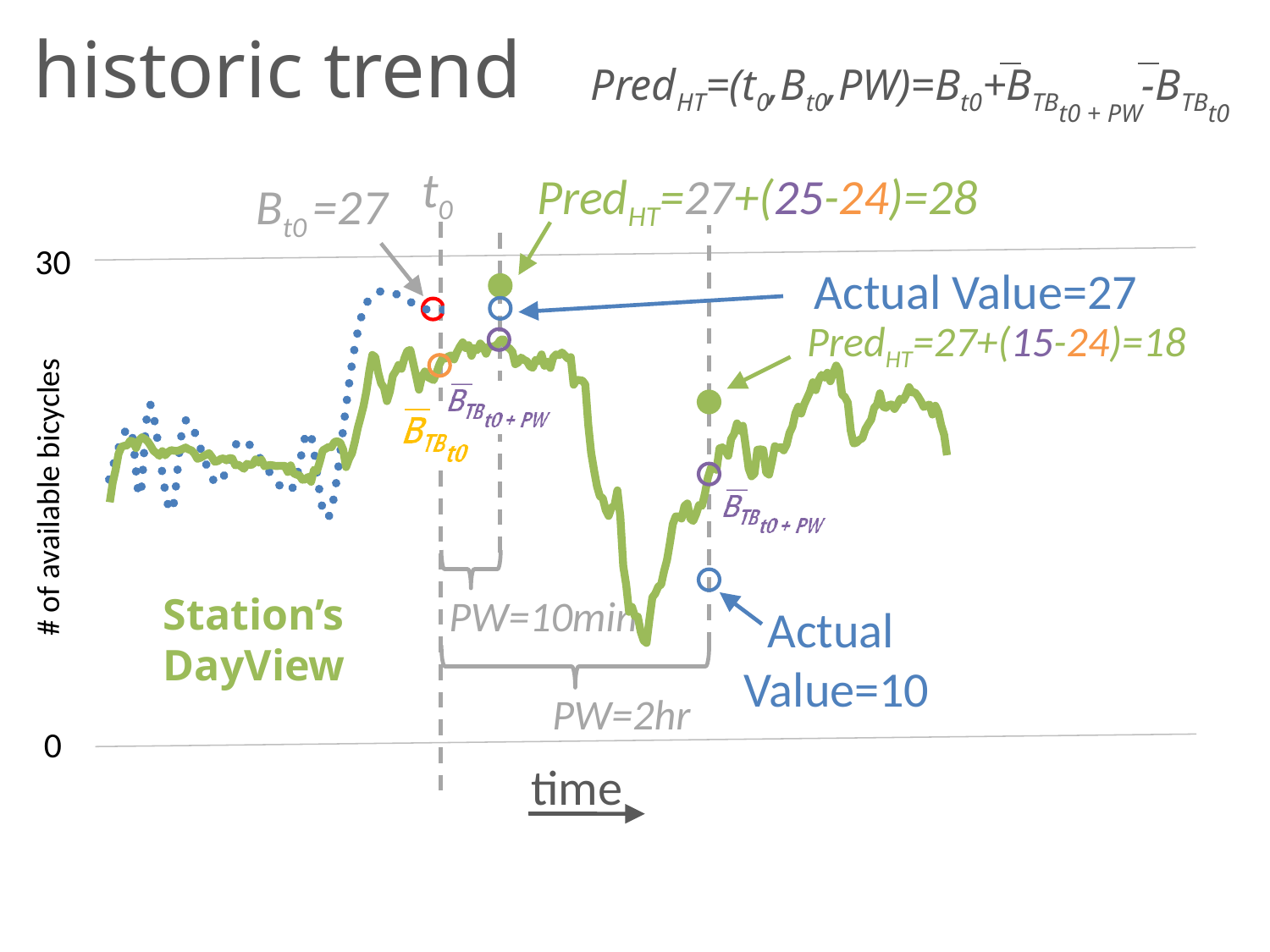
What is the difference between the predicted value (28) and the actual value (27) for the 10-minute prediction window? 1 What is the highest tick value shown on the y axis? 30 What is the value of B_t0 annotated on the chart? 27 What are the two prediction window lengths (PW) marked on the chart? 10min and 2hr What is the actual value at the end of the 10-minute prediction window? 27 What is the actual value at the end of the 2-hour prediction window? 10 What is the predicted value Pred_HT for the 10-minute prediction window? 28 What is the label of the y axis? # of available bicycles What is the difference between the predicted value (18) and the actual value (10) for the 2-hour prediction window? 8 What is the predicted value Pred_HT for the 2-hour prediction window? 18 Which is larger, the actual value for the 10-minute window or the actual value for the 2-hour window? the 10-minute window (27) What kind of chart is shown on the slide? line chart